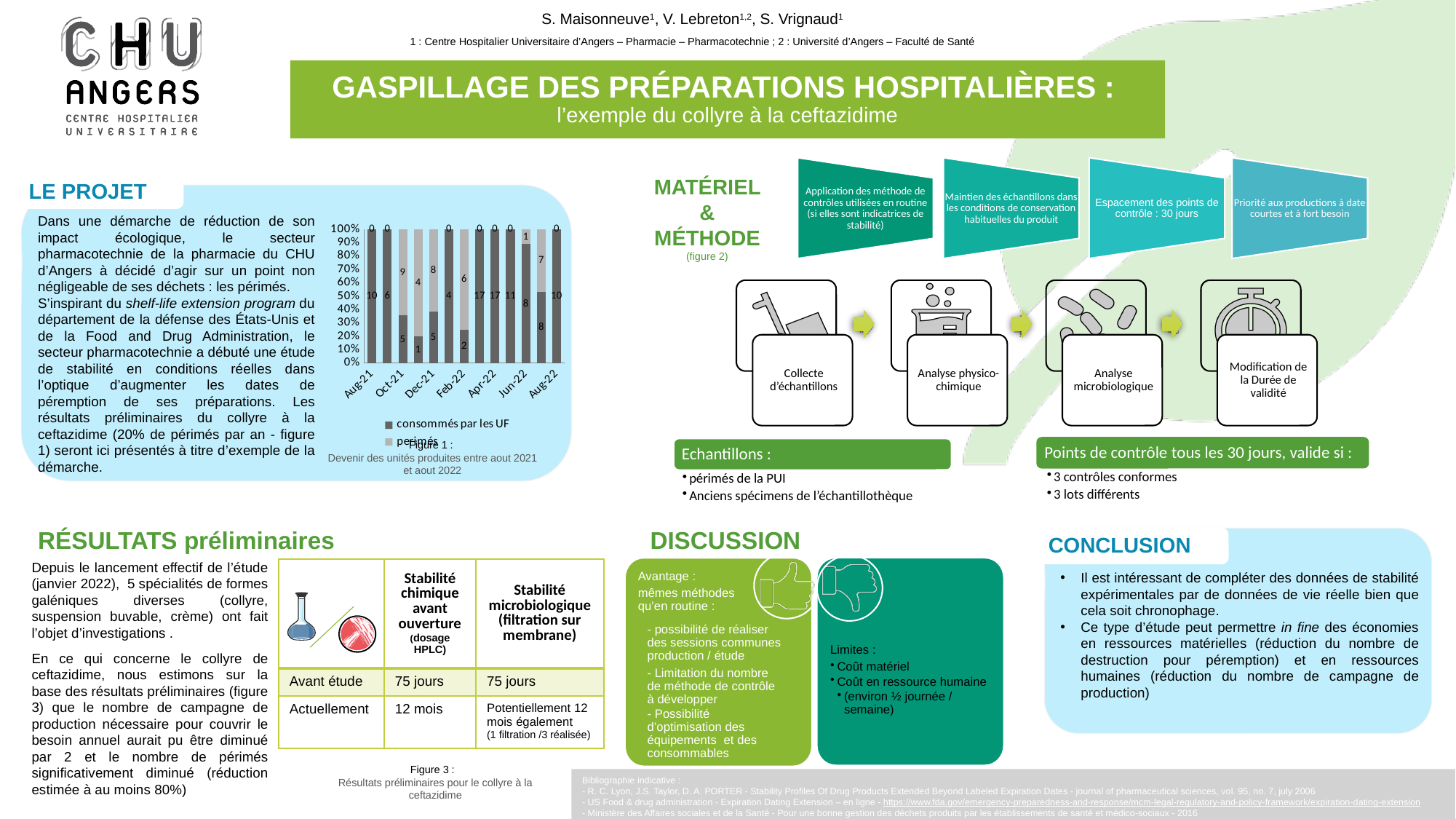
In Figure 1, what is the value of 'périmés' for Aug-22? 0 In Figure 1, for Oct-21, which is larger: 'consommés par les UF' or 'périmés'? périmés In Figure 1, what is the value of 'périmés' for Dec-21? 8 How many bars are plotted in Figure 1? 13 What is the caption/title of Figure 1? Devenir des unités produites entre aout 2021 et aout 2022 What kind of chart is Figure 1 (Devenir des unités produites entre aout 2021 et aout 2022)? Stacked bar chart In Figure 1, what is the difference between 'périmés' and 'consommés par les UF' for Oct-21? 4 In Figure 1, what is the value of 'consommés par les UF' for Aug-21? 10 In Figure 1, what is the highest value shown for 'consommés par les UF'? 17 In Figure 1, what is the value of 'périmés' for Oct-21? 9 In Figure 1, is the share of 'consommés par les UF' for Aug-21 greater or less than 90%? greater In Figure 1, what is the value of 'consommés par les UF' for Apr-22? 17